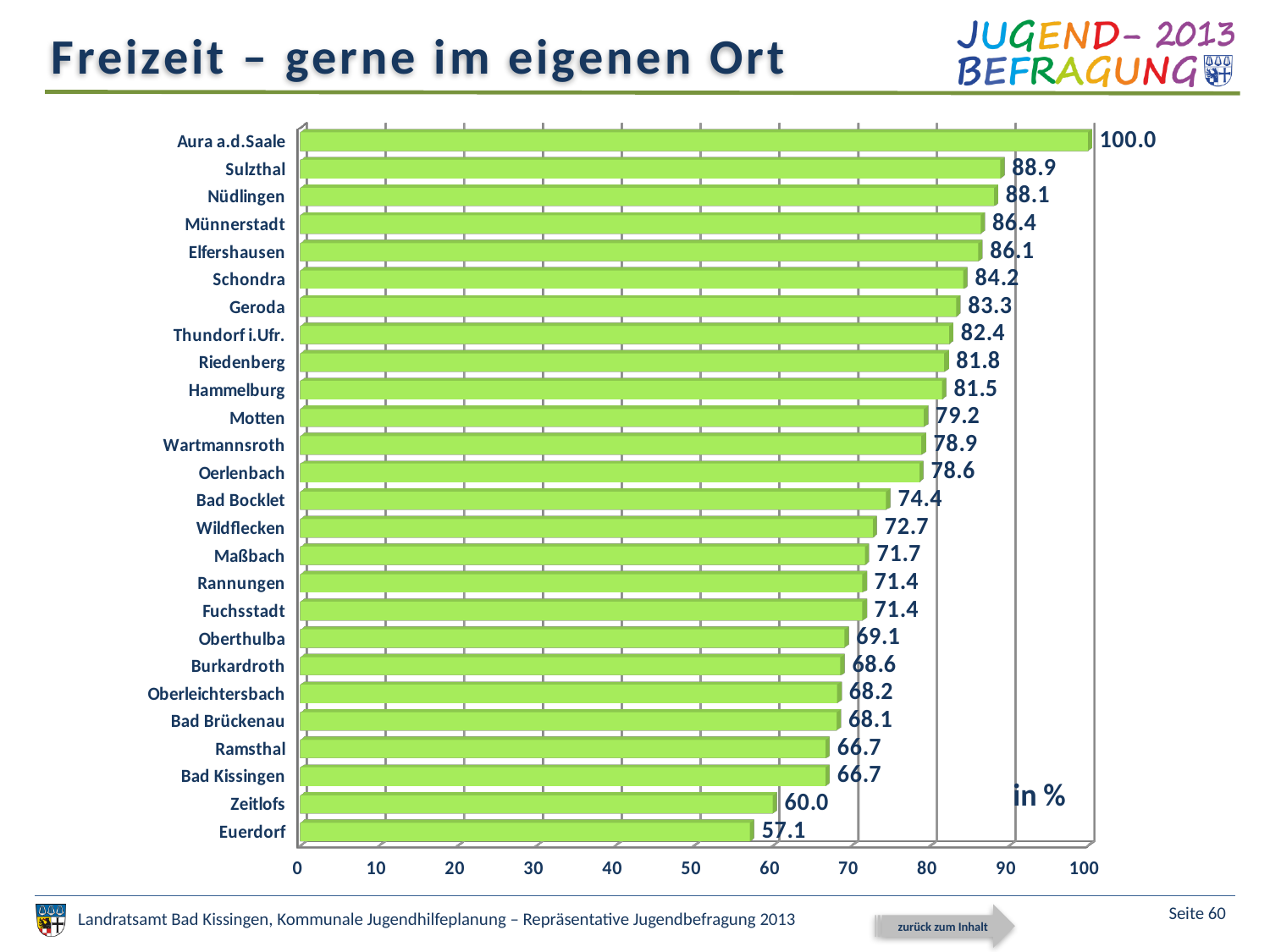
What is the value for Hammelburg? 81.5 Is the value for Wildflecken greater or less than 70? greater Which category has the lowest value? Euerdorf Which category has the highest value? Aura a.d.Saale Which is larger, the value for Motten or the value for Bad Bocklet? Motten What unit is indicated on the chart? in % What is the difference between the values for Sulzthal and Zeitlofs? 28.9 What is the value for Bad Kissingen? 66.7 What kind of chart is shown on the slide? bar chart What is the title of the slide? Freizeit – gerne im eigenen Ort What is the value for Aura a.d.Saale? 100.0 How many categories are shown in the chart? 26